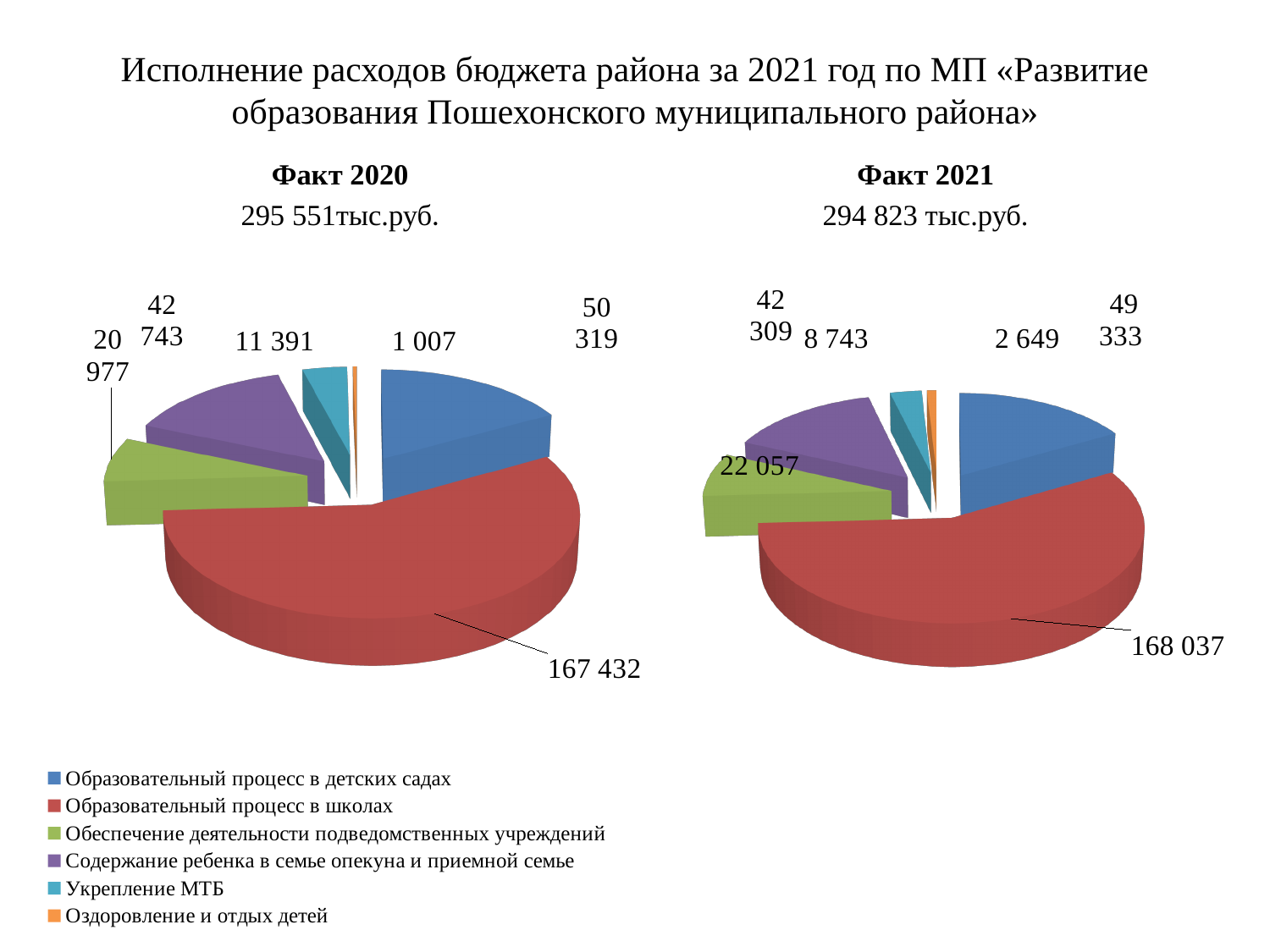
In the Факт 2021 chart, what is the value for Образовательный процесс в детских садах? 49 333 What kind of chart is used on this slide? Pie chart In the Факт 2020 chart, what is the difference between Образовательный процесс в школах and Образовательный процесс в детских садах? 117 113 In the Факт 2020 chart, what is the value for Образовательный процесс в школах? 167 432 In the Факт 2020 chart, what is the value for Укрепление МТБ? 11 391 In the Факт 2021 chart, what is the value for Оздоровление и отдых детей? 2 649 In the Факт 2020 chart, which category has the largest slice? Образовательный процесс в школах In the Факт 2021 chart, which category has the smallest slice? Оздоровление и отдых детей How many categories does the legend list? 6 In the Факт 2021 chart, what is the value for Обеспечение деятельности подведомственных учреждений? 22 057 Which is larger: Содержание ребенка в семье опекуна и приемной семье in the Факт 2020 chart or in the Факт 2021 chart? Факт 2020 What total is printed under the heading Факт 2021? 294 823 тыс.руб.